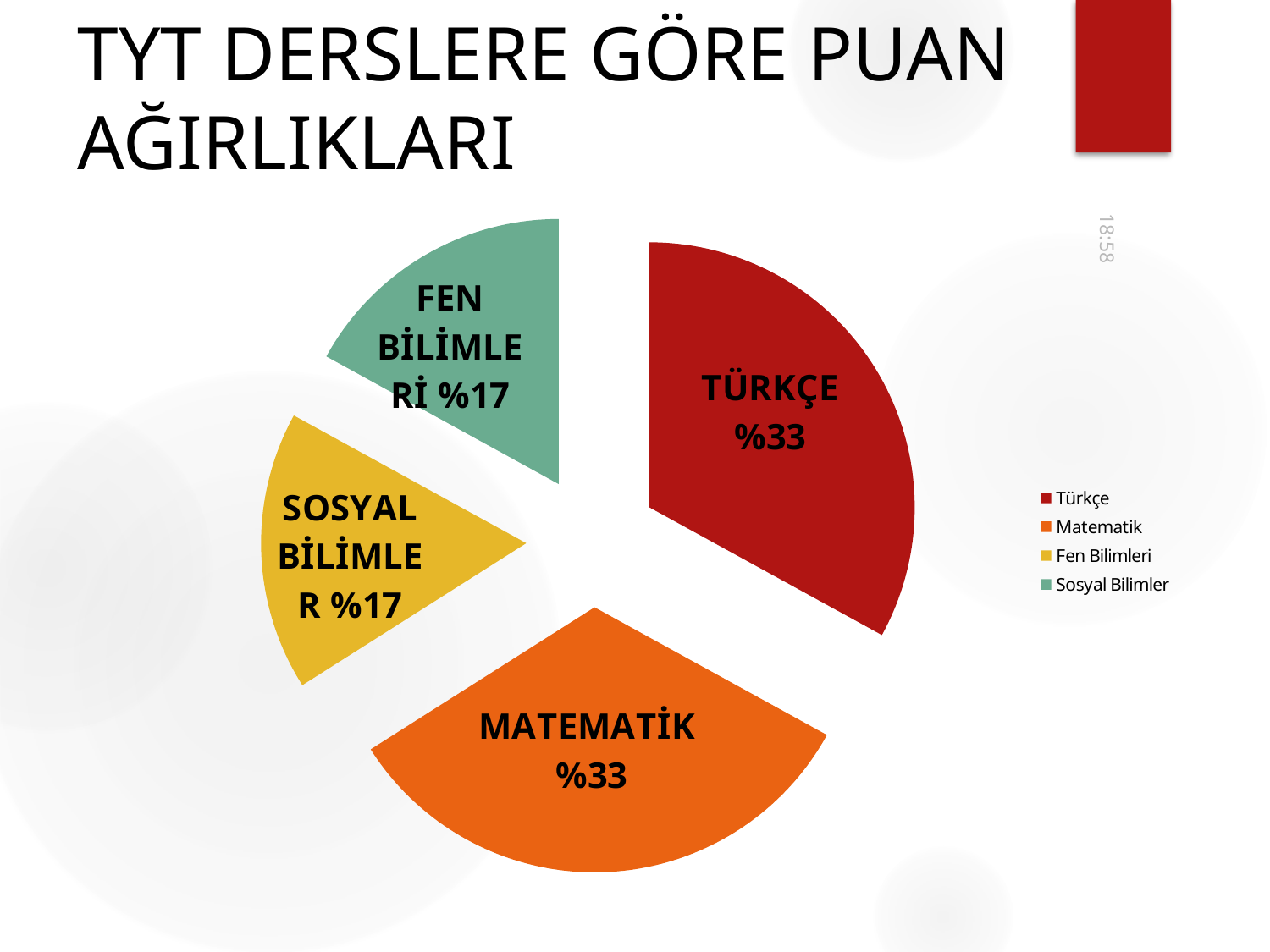
Which is larger, the share for Türkçe or the share for Fen Bilimleri? Türkçe What percentage is labelled on the Sosyal Bilimler slice? %17 Which is larger, the share for Sosyal Bilimler or the share for Matematik? Matematik What is the share shown for Türkçe in the pie chart? %33 What is the difference in percentage points between the Matematik share and the Sosyal Bilimler share? 16 How many entries does the legend list? 4 What percentage is labelled on the Fen Bilimleri slice? %17 Which legend entry is shown in red? Türkçe What kind of chart is shown on the slide? pie chart What is the title of the slide containing the pie chart? TYT DERSLERE GÖRE PUAN AĞIRLIKLARI What is the share shown for Matematik in the pie chart? %33 How many slices does the pie chart have? 4